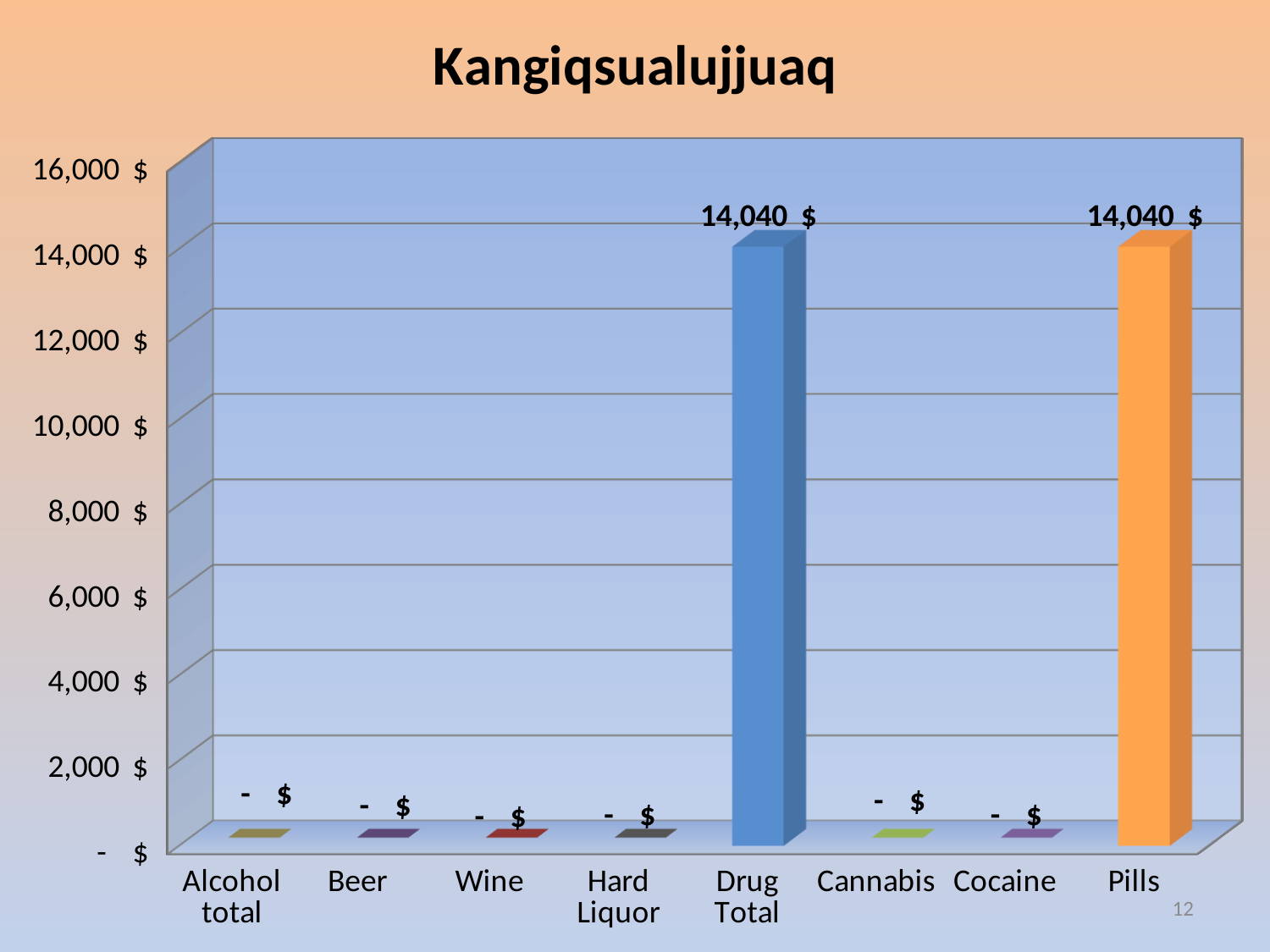
Is the value for Drug Total greater or less than 16,000 $? less What kind of chart is shown on the slide? Bar chart How many categories are shown on the x axis? 8 What is the value for Pills? 14,040 $ What is the title of the chart? Kangiqsualujjuaq Is the value for Pills greater or less than 12,000 $? greater What colour is the bar for Pills? Orange Which is larger, the value for Wine or the value for Drug Total? Drug Total What is the value shown for Cannabis? - $ What is the difference between the values for Drug Total and Pills? 0 $ What is the value for Drug Total? 14,040 $ What is the value shown for Beer? - $